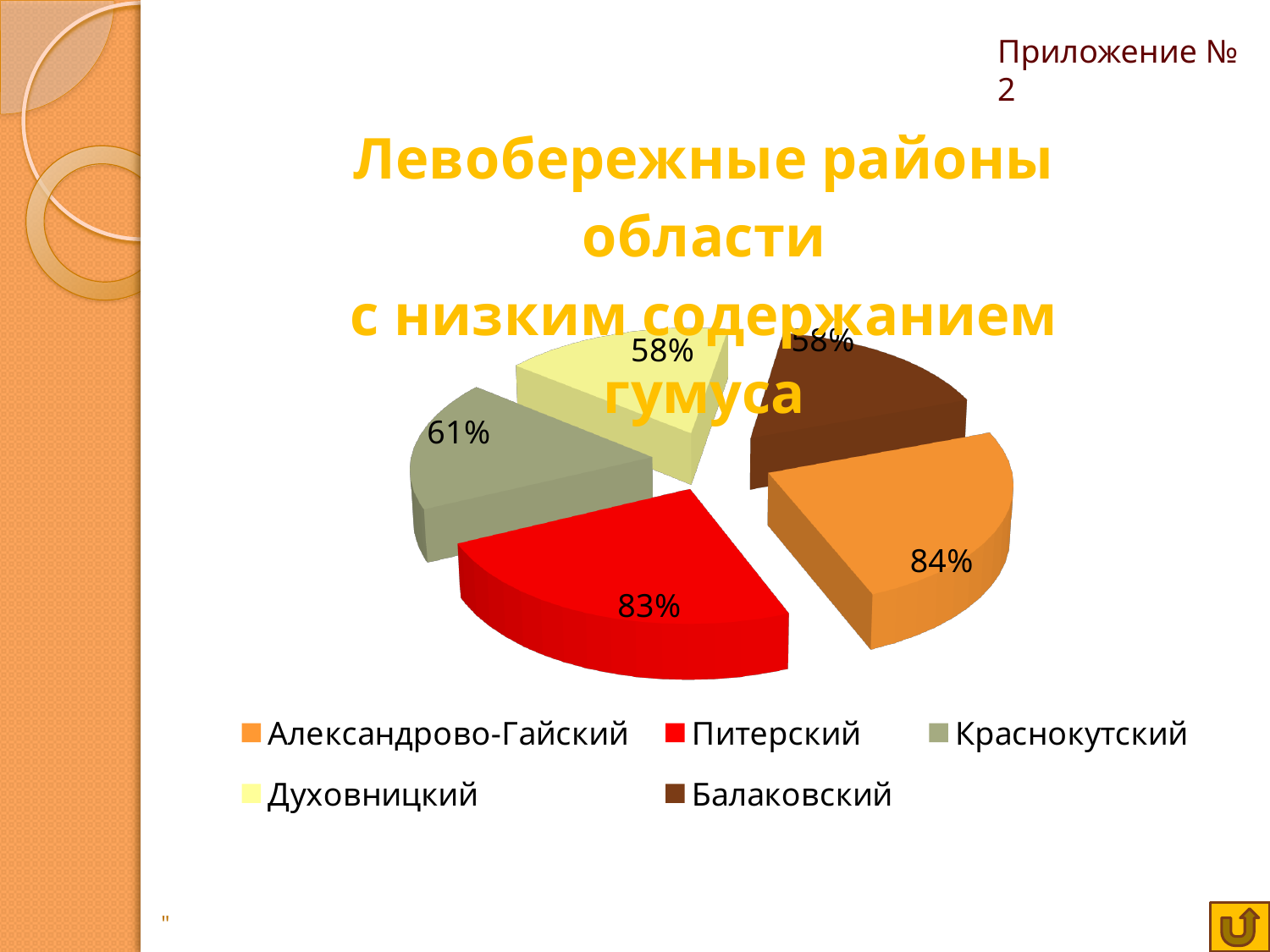
Which district is shown in brown in the legend? Балаковский What value is shown for Питерский? 83% What value is shown for Духовницкий? 58% What value is shown for Александрово-Гайский? 84% Which district has the highest value in the chart? Александрово-Гайский Which is larger, the value for Питерский or the value for Краснокутский? Питерский What is the difference between the values for Александрово-Гайский and Краснокутский? 23% What is the difference between the values for Питерский and Духовницкий? 25% What kind of chart is shown on the slide? pie chart What value is shown for Краснокутский? 61% What colour is the slice for Питерский? red How many slices does the pie chart have? 5